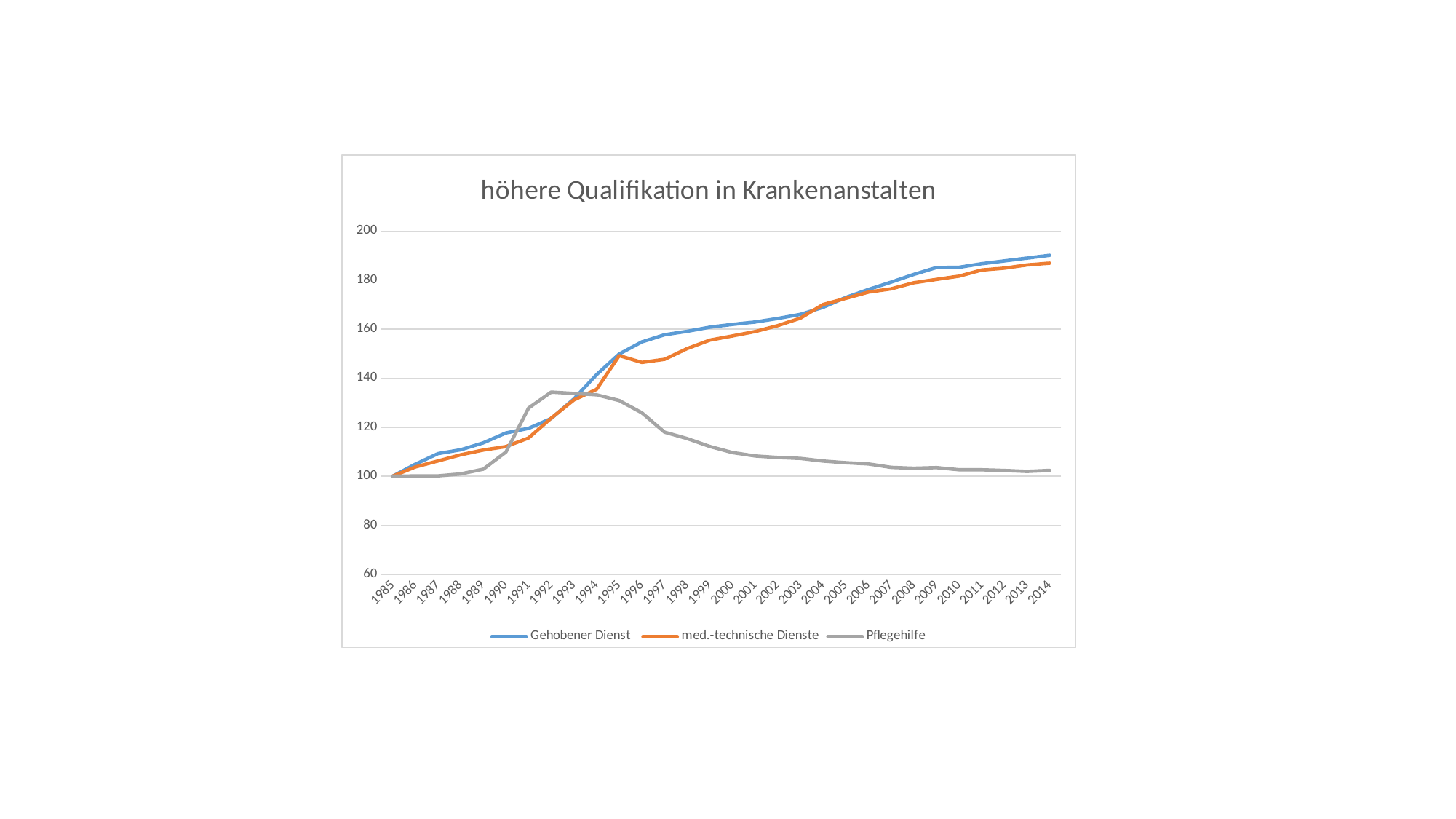
Which series has the lowest value in 2014? Pflegehilfe Is the value for Pflegehilfe in 2014 greater or less than 120? less Is the value for Gehobener Dienst in 2014 greater or less than 180? greater What is the title of the chart? höhere Qualifikation in Krankenanstalten Does the value for Pflegehilfe rise or fall from 1992 to 2014? fall What kind of chart is shown on the slide? line chart How many series does the legend list? 3 How many years are shown on the x axis? 30 What is the value for Gehobener Dienst in 1985? 100 In 1992, which is larger: the value for Pflegehilfe or the value for Gehobener Dienst? Pflegehilfe What is the value for Pflegehilfe in 1985? 100 Which series has the highest value in 2014? Gehobener Dienst